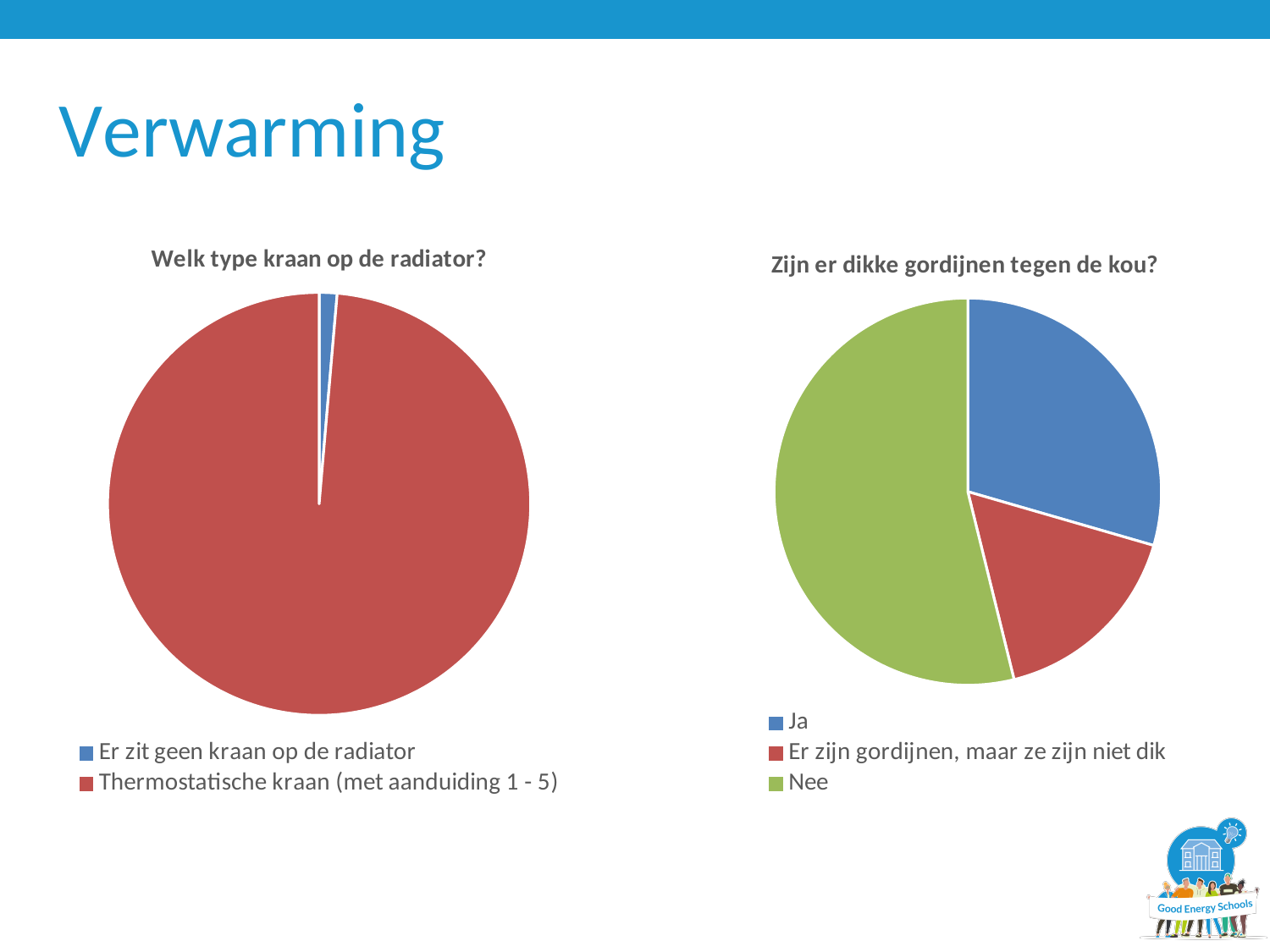
In the chart 'Welk type kraan op de radiator?', which category has the smallest slice? Er zit geen kraan op de radiator In the chart 'Welk type kraan op de radiator?', which category has the largest slice? Thermostatische kraan (met aanduiding 1 - 5) What kind of chart is 'Welk type kraan op de radiator?'? pie chart In the chart 'Zijn er dikke gordijnen tegen de kou?', how many entries does the legend list? 3 In the chart 'Zijn er dikke gordijnen tegen de kou?', which category has the smallest slice? Er zijn gordijnen, maar ze zijn niet dik In the chart 'Welk type kraan op de radiator?', how many slices does the pie have? 2 In the chart 'Zijn er dikke gordijnen tegen de kou?', which category has the largest slice? Nee In the chart 'Zijn er dikke gordijnen tegen de kou?', which slice is larger: 'Ja' or 'Er zijn gordijnen, maar ze zijn niet dik'? Ja What kind of chart is 'Zijn er dikke gordijnen tegen de kou?'? pie chart In the chart 'Zijn er dikke gordijnen tegen de kou?', what colour is the 'Nee' slice? green In the chart 'Zijn er dikke gordijnen tegen de kou?', which slice is larger: 'Nee' or 'Ja'? Nee In the chart 'Zijn er dikke gordijnen tegen de kou?', how many slices does the pie have? 3